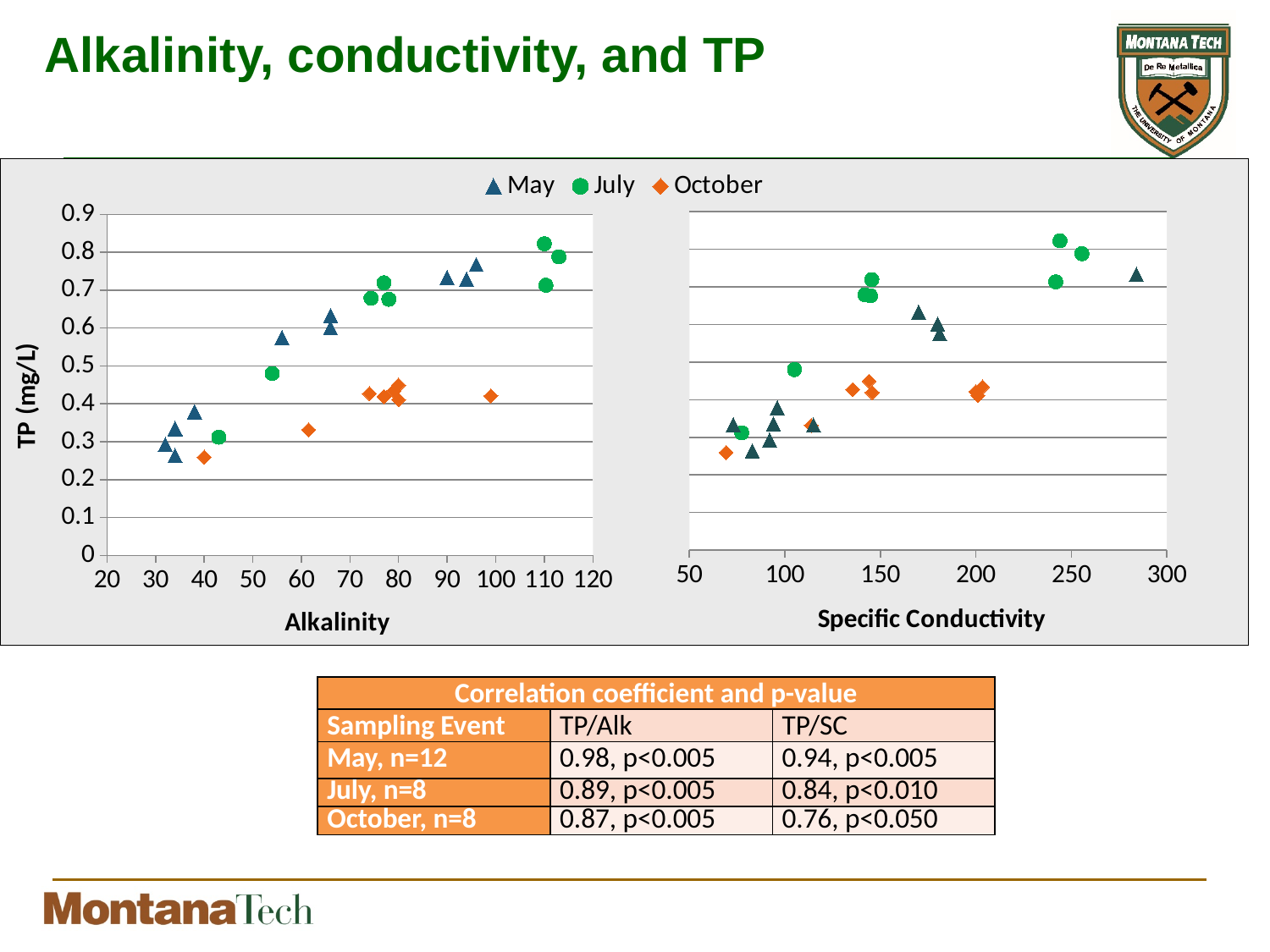
What kind of chart is the left chart with the Alkalinity x-axis? scatter chart In the right chart (Specific Conductivity), does TP generally rise or fall as specific conductivity increases? rise In the left chart (Alkalinity), are the October points near an alkalinity of 80 greater or less than 0.5 mg/L TP? less In the right chart (Specific Conductivity), is the May point near a conductivity of 285 greater or less than 0.6 mg/L TP? greater In the left chart (Alkalinity), is the highest July point greater or less than 0.8 mg/L TP? greater How many series does the legend list for the charts? 3 What are the series names shown in the legend? May, July, October In the left chart (Alkalinity), which series reaches the highest TP value? July How many scatter charts are shown on the slide? 2 In the left chart (Alkalinity), does TP generally rise or fall as alkalinity increases? rise What is the x-axis title of the right chart? Specific Conductivity